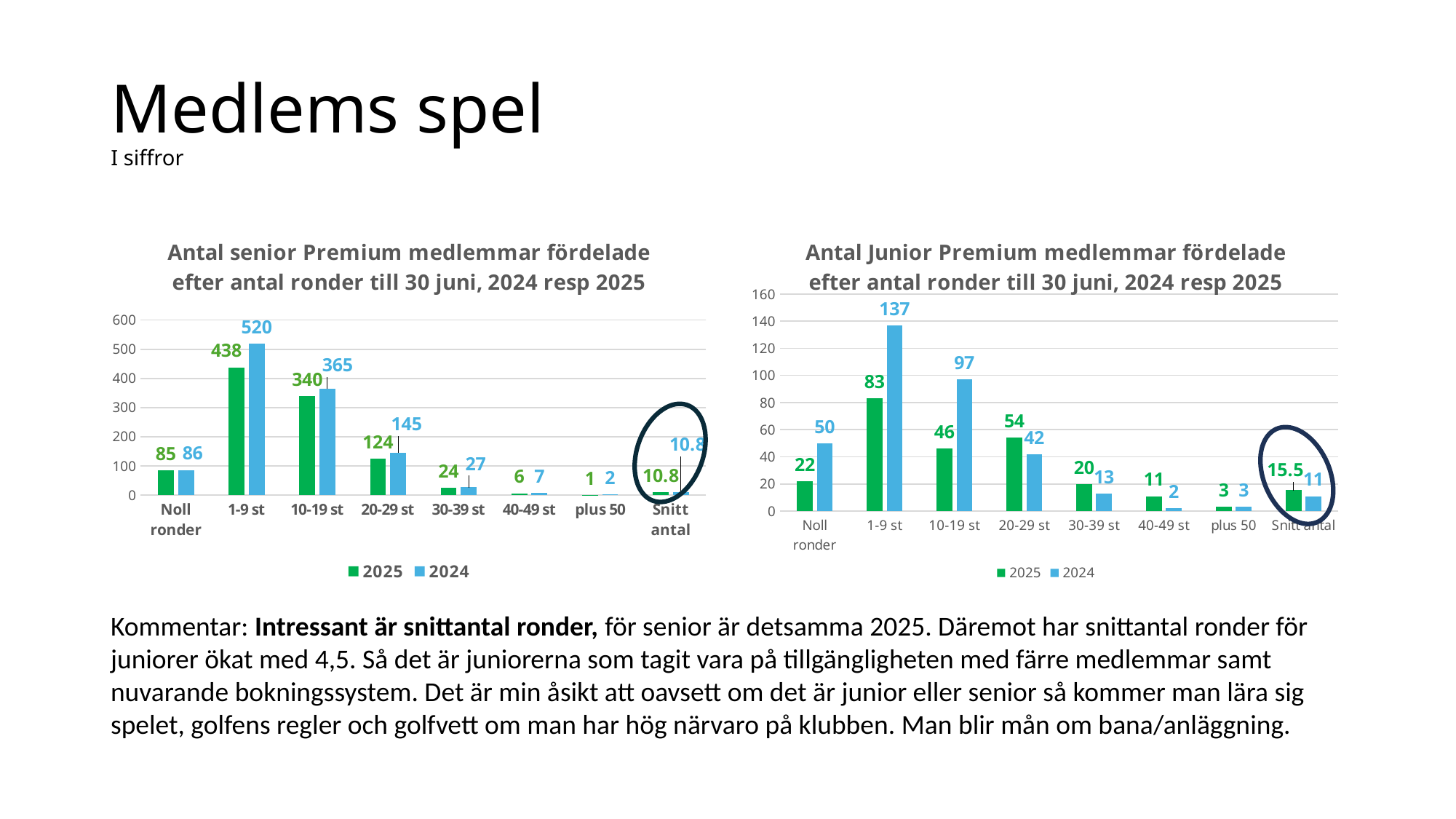
In the senior chart (left), what is the 2025 value for the 20-29 st category? 124 What type of chart is the senior chart (left)? Bar chart How many series does the legend of the junior chart (right) list? 2 In the junior chart (right), what is the difference between the 2024 and 2025 values for Noll ronder? 28 In the senior chart (left), which category has the highest 2025 value? 1-9 st In the junior chart (right), which is larger for 20-29 st: the 2025 value or the 2024 value? 2025 In the senior chart (left), what is the 2024 value for the 1-9 st category? 520 How many categories are shown on the x axis of the senior chart (left)? 8 In the senior chart (left), what is the difference between the 2024 and 2025 values for 10-19 st? 25 In the junior chart (right), which category has the lowest 2024 value? 40-49 st In the junior chart (right), what is the 2025 value for Snitt antal? 15.5 In the junior chart (right), what is the 2024 value for the 10-19 st category? 97